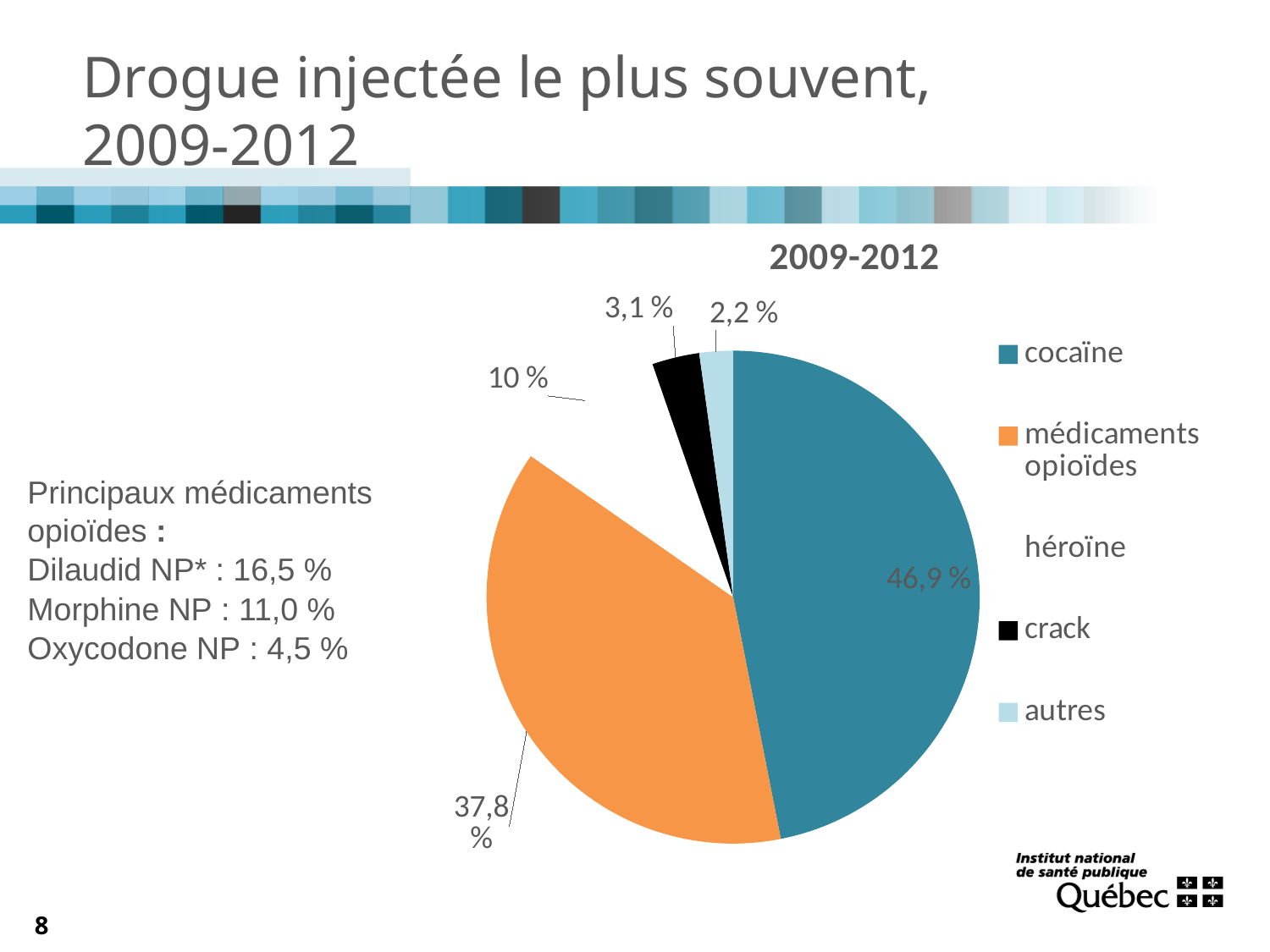
How many categories does the legend of the pie chart list? 5 What is the share for médicaments opioïdes in the pie chart? 37,8 % What is the share for cocaïne in the pie chart? 46,9 % Which category has the smallest slice of the pie chart? autres What is the share for autres in the pie chart? 2,2 % What is the difference between the shares for cocaïne and médicaments opioïdes? 9,1 % What is the share for héroïne in the pie chart? 10 % What is the title shown above the pie chart? 2009-2012 Which is larger, the share for crack or the share for autres? crack What is the share for crack in the pie chart? 3,1 % What kind of chart is shown on the slide? pie chart Which category has the largest slice of the pie chart? cocaïne